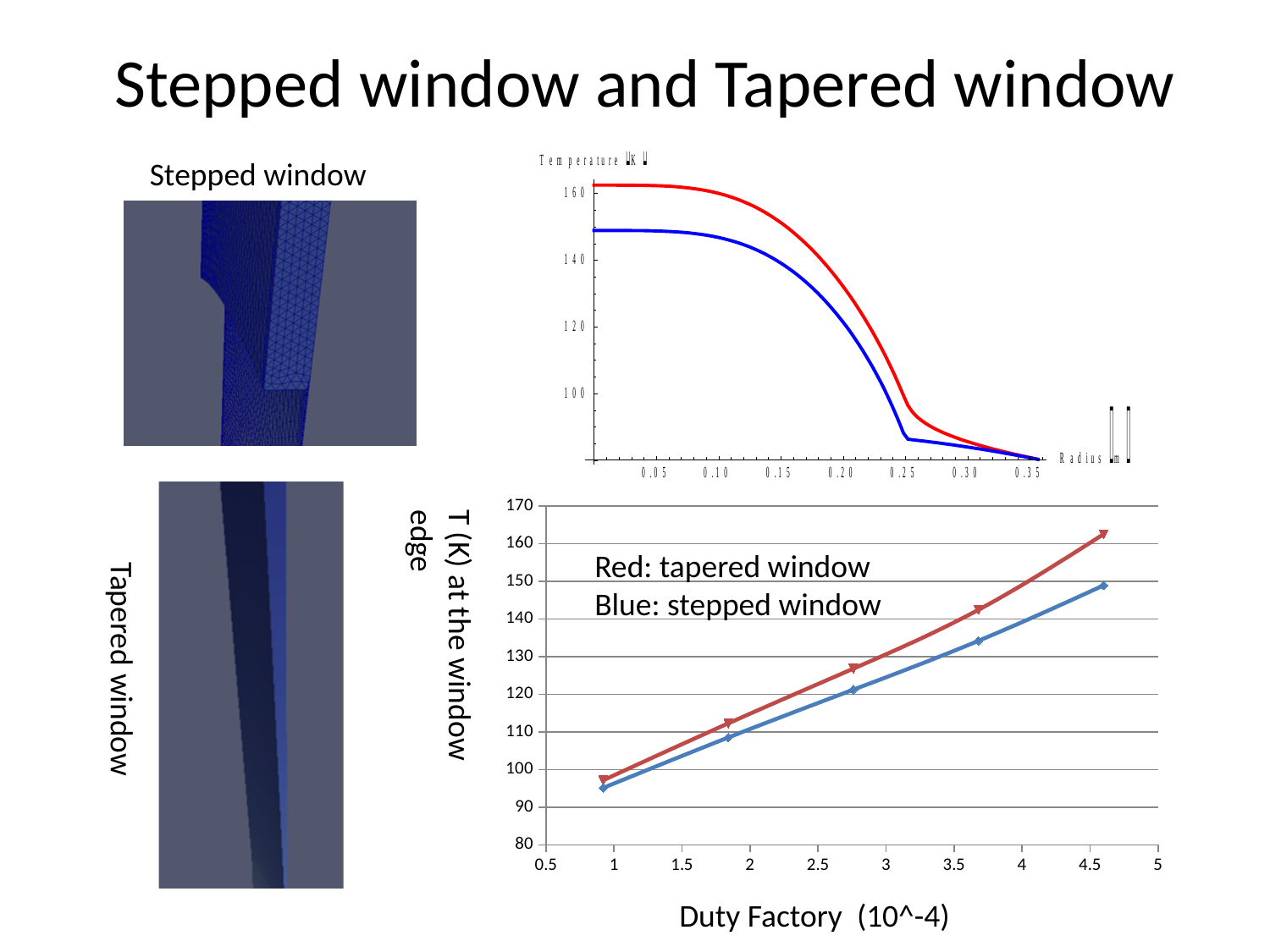
In the bottom-right chart (T at the window edge vs Duty Factory), do the values rise or fall as Duty Factory increases? rise In the bottom-right chart, is the value of the red (tapered window) series at its third point (Duty Factory about 2.75) greater or less than 120? greater In the top-right Temperature vs Radius chart, do the temperature curves rise or fall as Radius increases? fall In the top-right Temperature vs Radius chart, is the blue curve's temperature at Radius 0.25 greater or less than 100? less In the bottom-right chart, is the value of the blue (stepped window) series at its first point (Duty Factory about 0.9) greater or less than 100? less What kind of chart is the bottom-right chart of T (K) at the window edge versus Duty Factory? line chart In the bottom-right chart, which series has the higher temperature at the largest Duty Factory, red (tapered window) or blue (stepped window)? red (tapered window) In the top-right Temperature vs Radius chart, which curve starts at the higher temperature at small radius, red or blue? red In the bottom-right chart, how many data points does the red (tapered window) series have? 5 What is the x-axis title of the bottom-right chart? Duty Factory (10^-4)